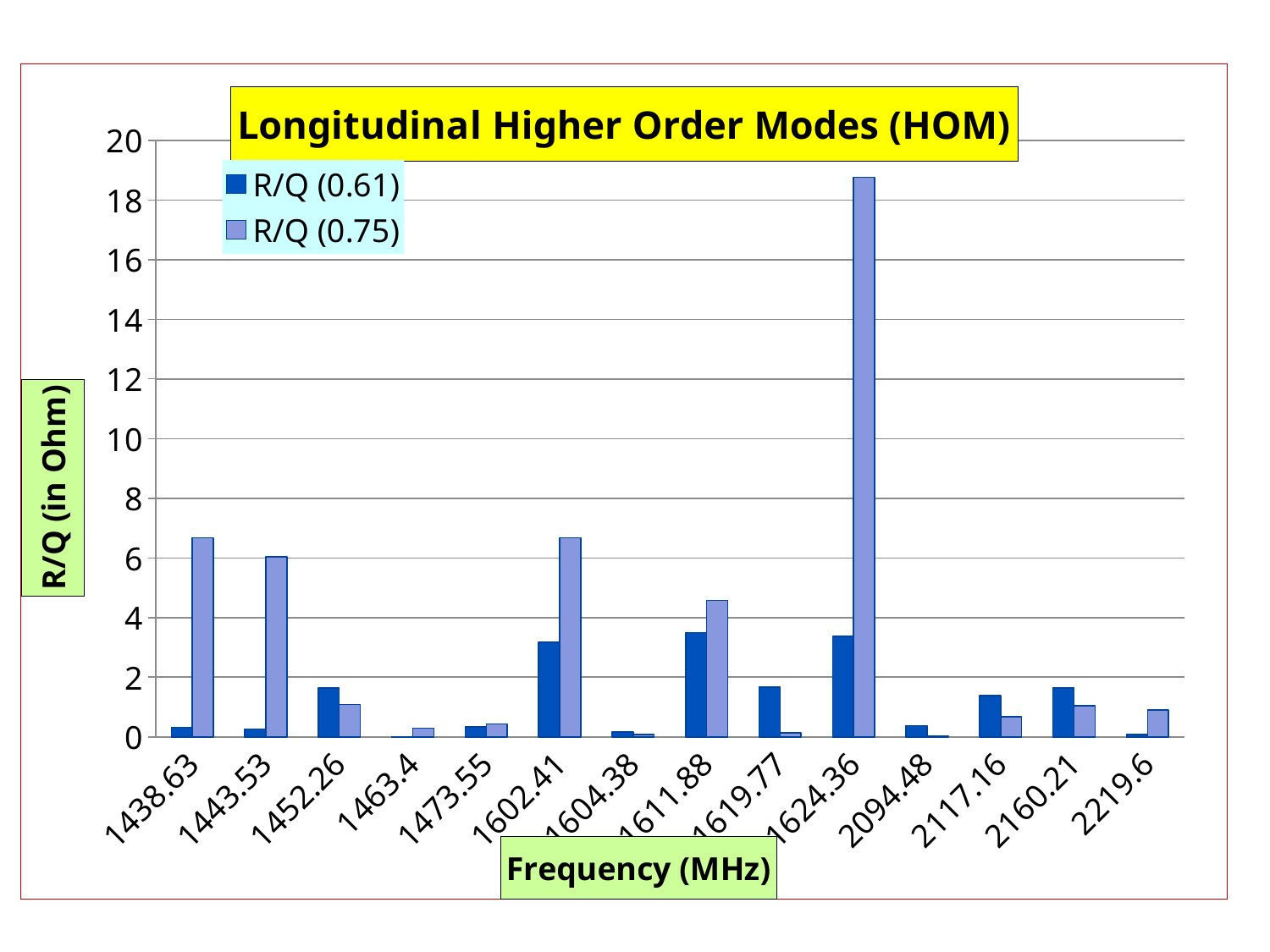
At 1438.63 MHz, which series has the larger value, R/Q (0.61) or R/Q (0.75)? R/Q (0.75) How many series does the legend list? 2 Is the R/Q (0.75) value at 1624.36 MHz greater or less than 16? greater What kind of chart is shown on the slide? bar chart Is the R/Q (0.61) value at 1602.41 MHz greater or less than 2? greater Is the R/Q (0.75) value at 1611.88 MHz greater or less than 4? greater At 1619.77 MHz, which series has the larger value, R/Q (0.61) or R/Q (0.75)? R/Q (0.61) What is the title of the chart? Longitudinal Higher Order Modes (HOM) How many frequency categories are shown on the x axis? 14 Which frequency has the highest R/Q (0.75) value? 1624.36